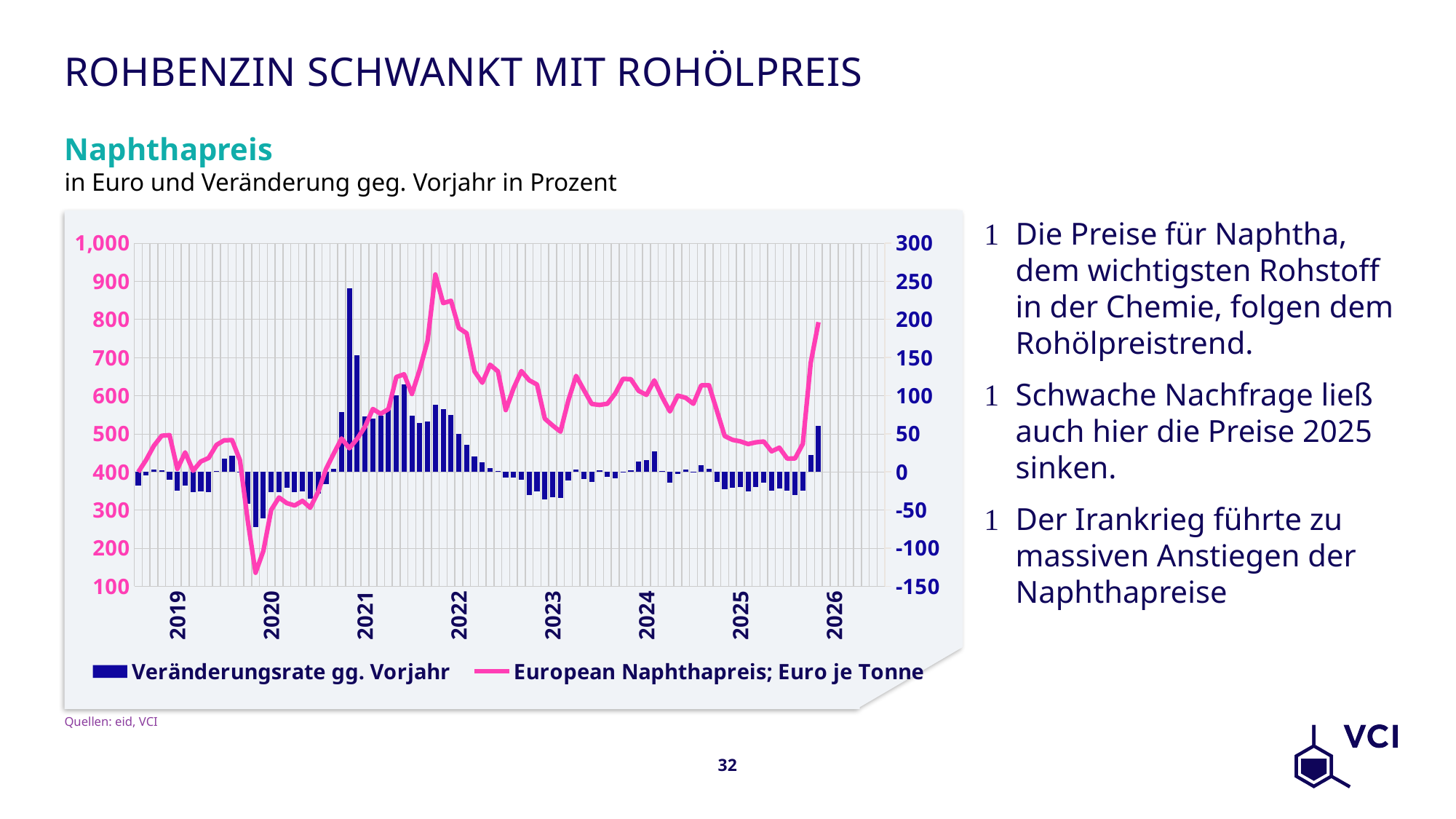
Is the highest value of the European Naphthapreis line greater or less than 800? greater How many series does the legend list? 2 Is the lowest value of the European Naphthapreis line greater or less than 200? less Which series is shown as the pink line in the chart? European Naphthapreis; Euro je Tonne What kind of chart is shown on the slide? A combined bar and line chart Is the tallest bar of the Veränderungsrate gg. Vorjahr greater or less than 200? greater Does the European Naphthapreis line rise or fall between its low in 2020 and the start of 2022? rise Does the European Naphthapreis line generally rise or fall between 2022 and 2025? fall How many years are labelled on the x axis of the chart? 8 Which series is shown as bars in the chart? Veränderungsrate gg. Vorjahr